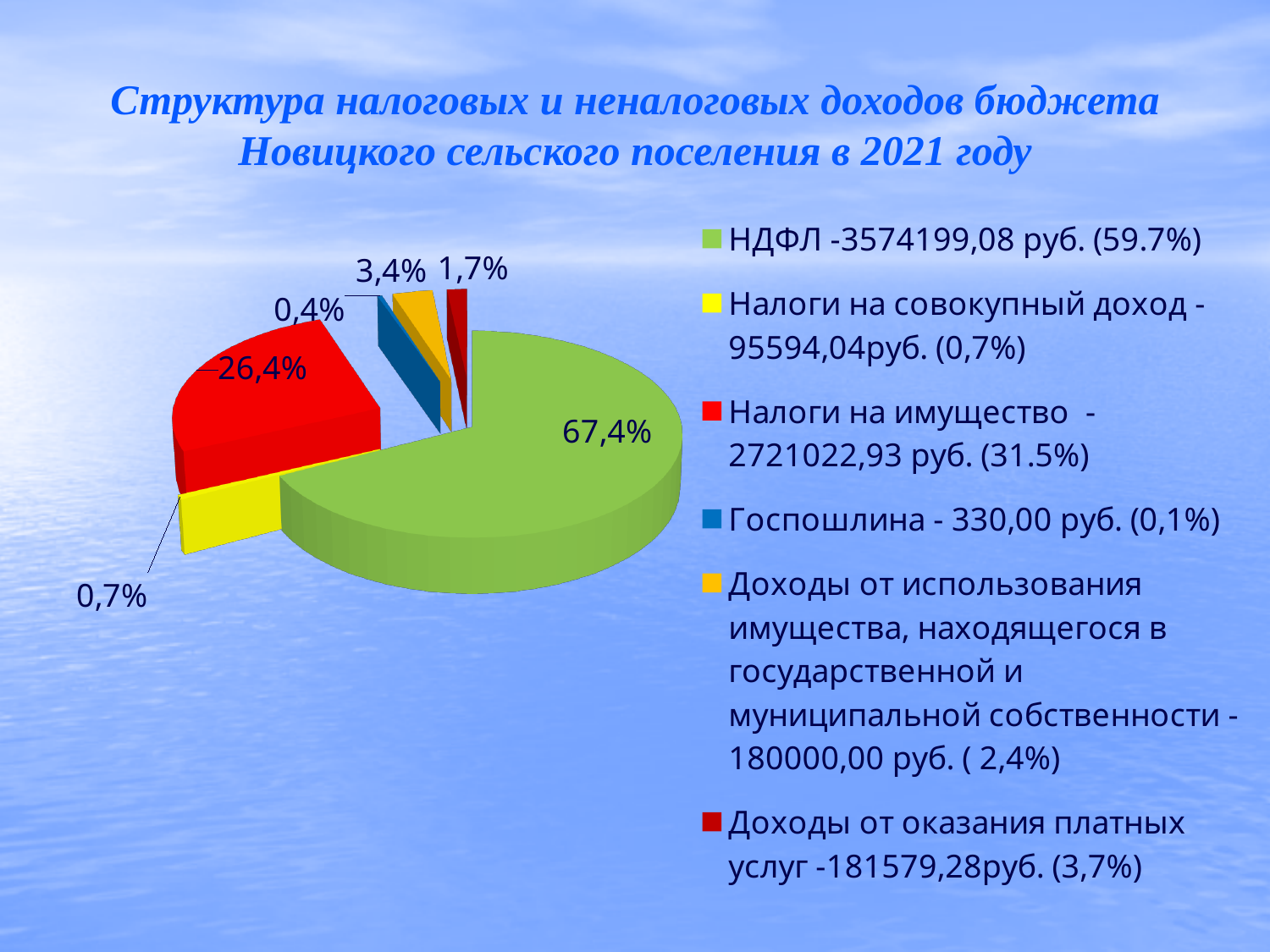
What kind of chart is shown on the slide? pie chart What data label is shown on the green НДФЛ slice of the pie chart? 67,4% How many entries does the legend list? 6 What data label is shown on the red Налоги на имущество slice of the pie chart? 26,4% What data label is shown for the orange slice (Доходы от использования имущества)? 3,4% Which slice is larger according to the chart labels: Налоги на имущество or Доходы от оказания платных услуг? Налоги на имущество What data label is shown for the yellow Налоги на совокупный доход slice? 0,7% How many slices does the pie chart have? 6 What data label is shown for the blue Госпошлина slice? 0,4% What colour is the НДФЛ slice in the pie chart? green Which category has the largest slice in the pie chart? НДФЛ Which category has the smallest slice in the pie chart? Госпошлина